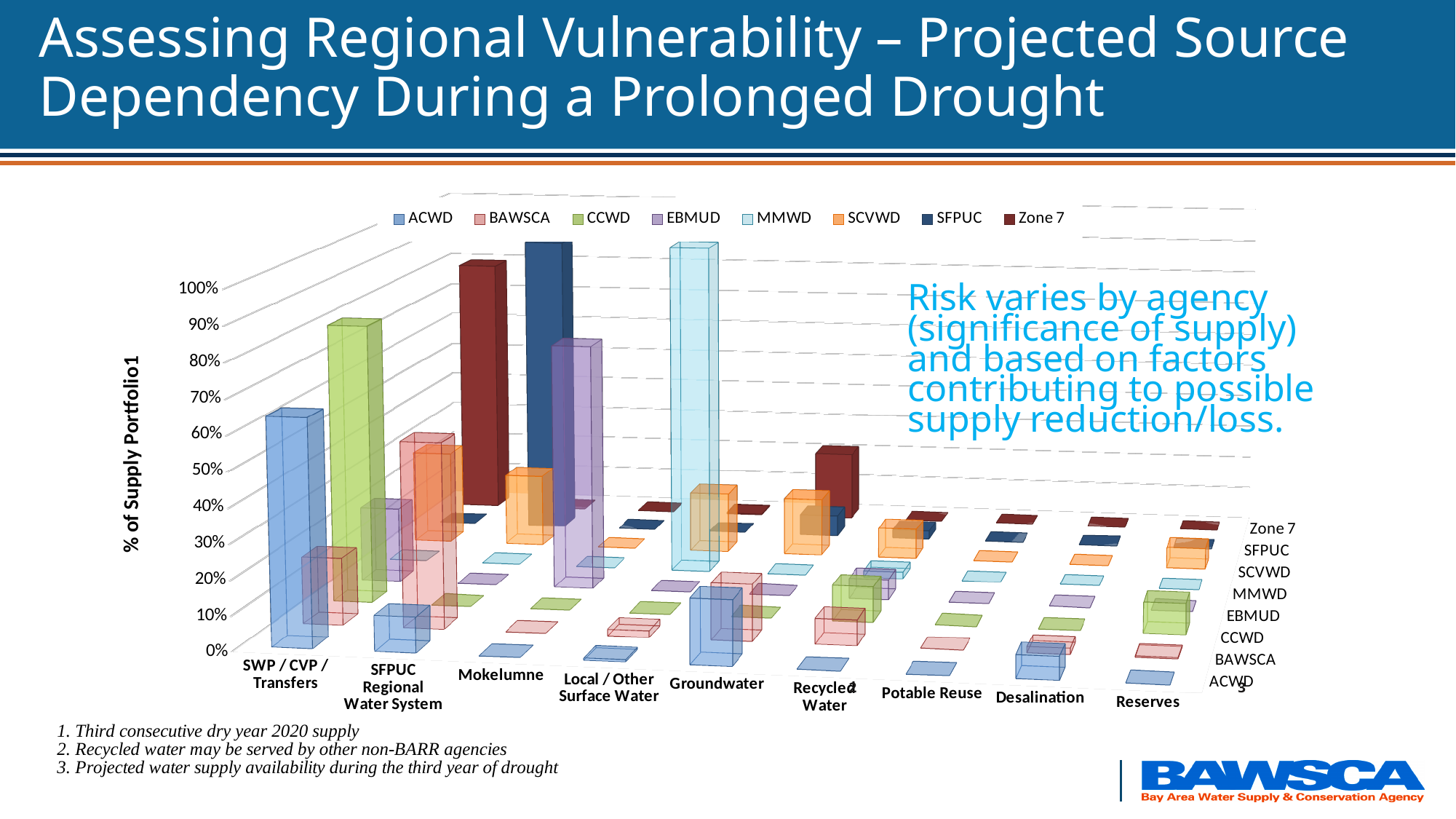
Which agency is listed first in the chart legend? ACWD What is the highest percentage tick shown on the vertical axis of the chart? 100% Is the ACWD value for SWP / CVP / Transfers greater or less than 50%? greater How many series does the chart legend list? 8 How many water source categories are shown along the x axis of the chart? 9 What kind of chart is shown on the slide? bar chart Is the ACWD value for Groundwater greater or less than 40%? less Which is larger for ACWD: the value for SWP / CVP / Transfers or the value for Groundwater? SWP / CVP / Transfers What is the label of the vertical axis of the chart? % of Supply Portfolio1 Is the ACWD value for Desalination greater or less than 20%? less